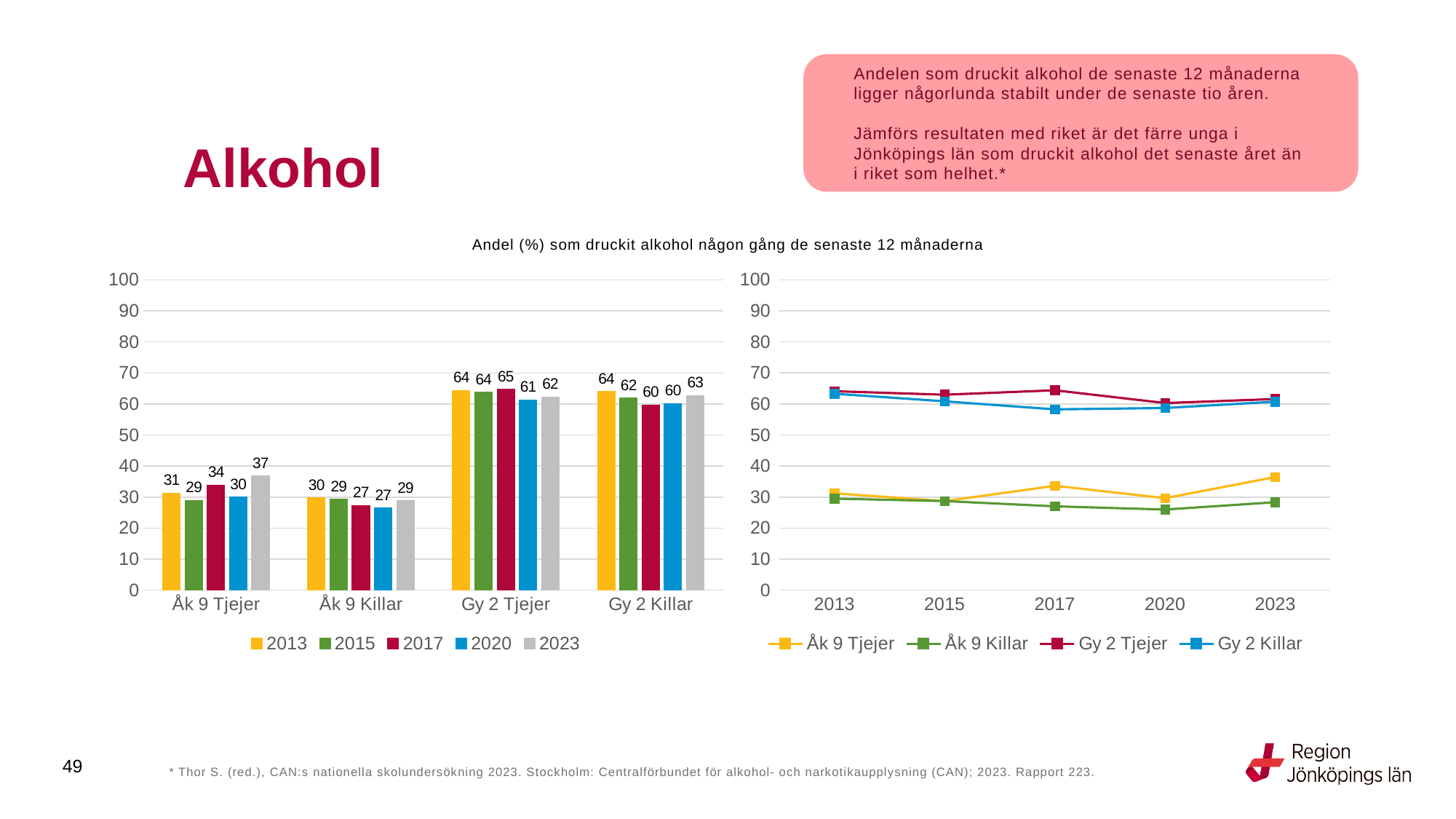
In the bar chart on the left, which year has the lowest value for Gy 2 Tjejer? 2020 In the bar chart on the left, which year has the highest value for Åk 9 Tjejer? 2023 In the bar chart on the left, what is the value for Gy 2 Tjejer in 2017? 65 In the bar chart on the left, what is the value for Åk 9 Killar in 2020? 27 In the line chart on the right, is the value for Åk 9 Killar in 2020 greater or less than 30? less How many series does the legend of the bar chart on the left list? 5 What kind of chart is the chart on the right? Line chart In the line chart on the right, is the value for Gy 2 Tjejer in 2017 greater or less than 60? greater In the bar chart on the left, what is the difference between the 2023 values for Gy 2 Killar and Åk 9 Killar? 34 In the bar chart on the left, what is the value for Åk 9 Tjejer in 2023? 37 How many categories are shown on the x axis of the bar chart on the left? 4 In the bar chart on the left, which is larger: the 2013 value for Åk 9 Tjejer or the 2013 value for Åk 9 Killar? Åk 9 Tjejer